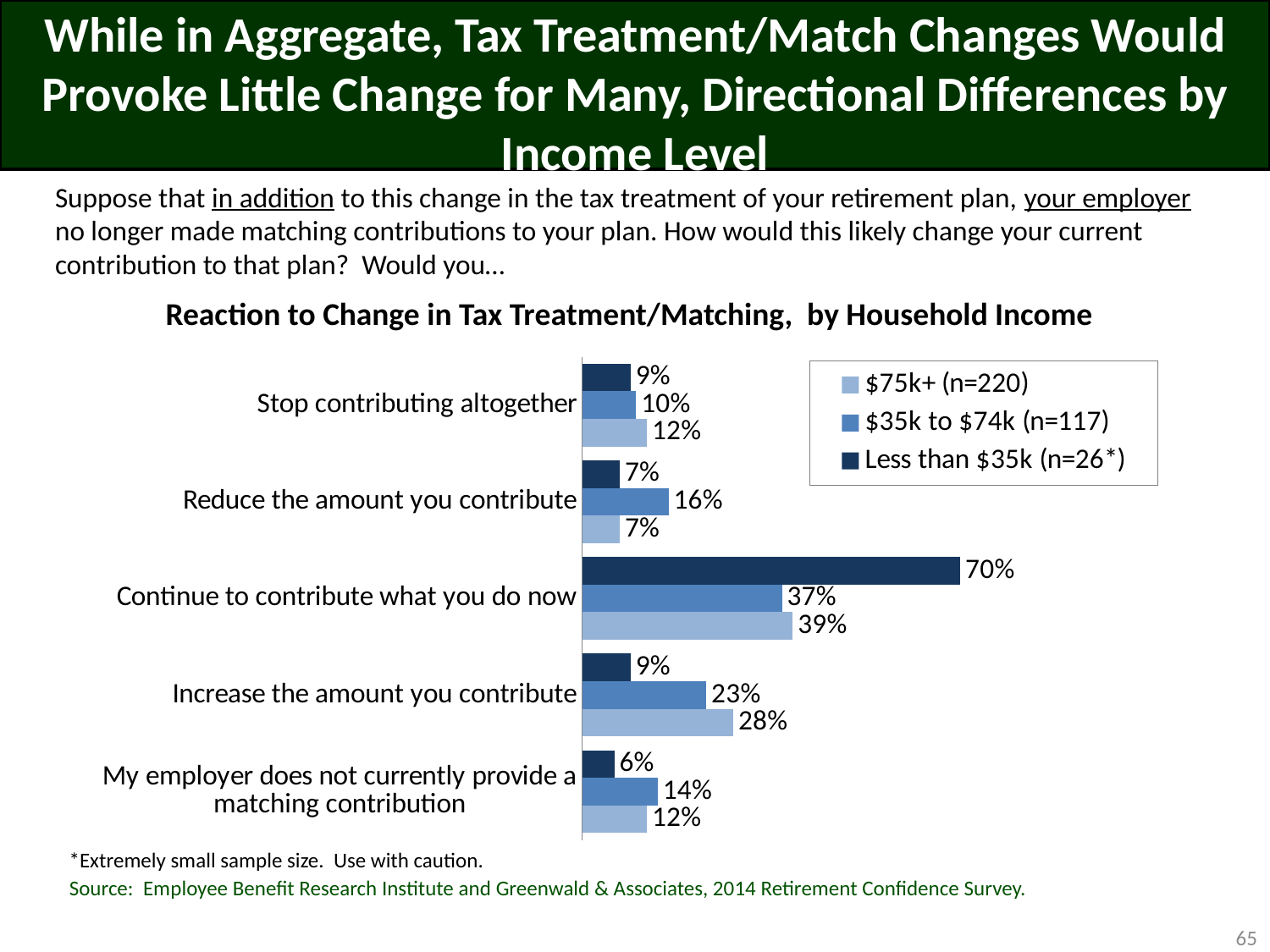
How many income groups does the legend list? 3 What percentage of respondents with household income of $75k+ would increase the amount they contribute? 28% What is the difference between the less than $35k and $35k to $74k groups for 'Continue to contribute what you do now'? 33 percentage points Which response category has the lowest value for the less than $35k income group? My employer does not currently provide a matching contribution What percentage of respondents with household income of less than $35k would continue to contribute what they do now? 70% Which response category has the highest value for the $75k+ income group? Continue to contribute what you do now What type of chart is used to show the reaction to change in tax treatment/matching? Bar chart What percentage of respondents with household income of $35k to $74k would reduce the amount they contribute? 16% What is the sample size for the less than $35k income group shown in the legend? n=26* How many response categories are shown on the chart? 5 What percentage of respondents with household income of $35k to $74k say their employer does not currently provide a matching contribution? 14% For 'Increase the amount you contribute', which income group has the larger value: $35k to $74k or $75k+? $75k+